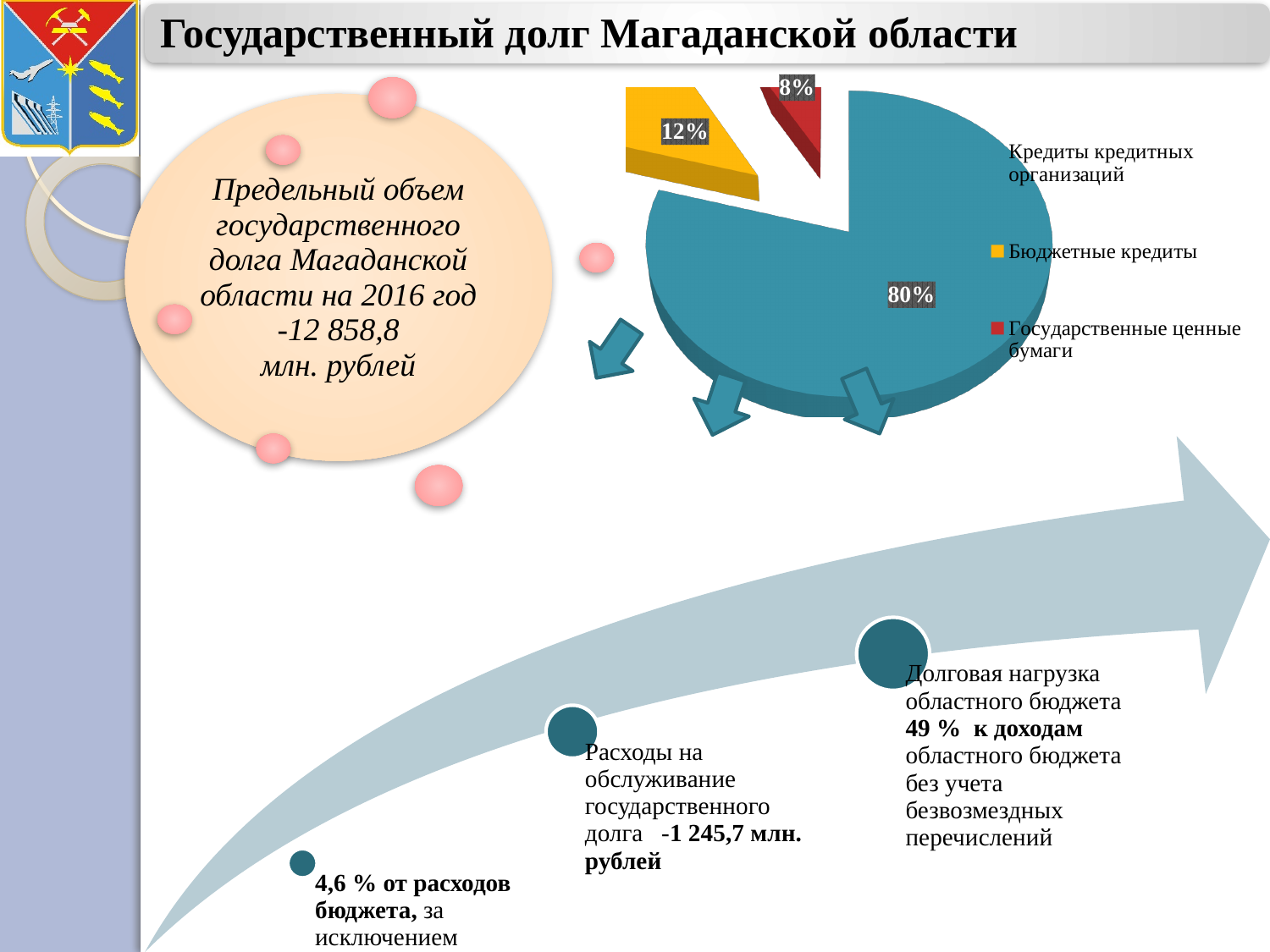
What share of the pie chart is Бюджетные кредиты? 12% What kind of chart is shown on the slide? pie chart What share of the pie chart is Государственные ценные бумаги? 8% Which category has the smallest slice in the pie chart? Государственные ценные бумаги What colour is the slice for Бюджетные кредиты in the pie chart? yellow What is the difference in percentage points between Бюджетные кредиты and Государственные ценные бумаги? 4 Which category has the largest slice in the pie chart? Кредиты кредитных организаций What is the difference in percentage points between Кредиты кредитных организаций and Бюджетные кредиты? 68 How many entries does the legend of the pie chart list? 3 What share of the pie chart is Кредиты кредитных организаций? 80% How many slices does the pie chart have? 3 Which is larger in the pie chart: Бюджетные кредиты or Государственные ценные бумаги? Бюджетные кредиты